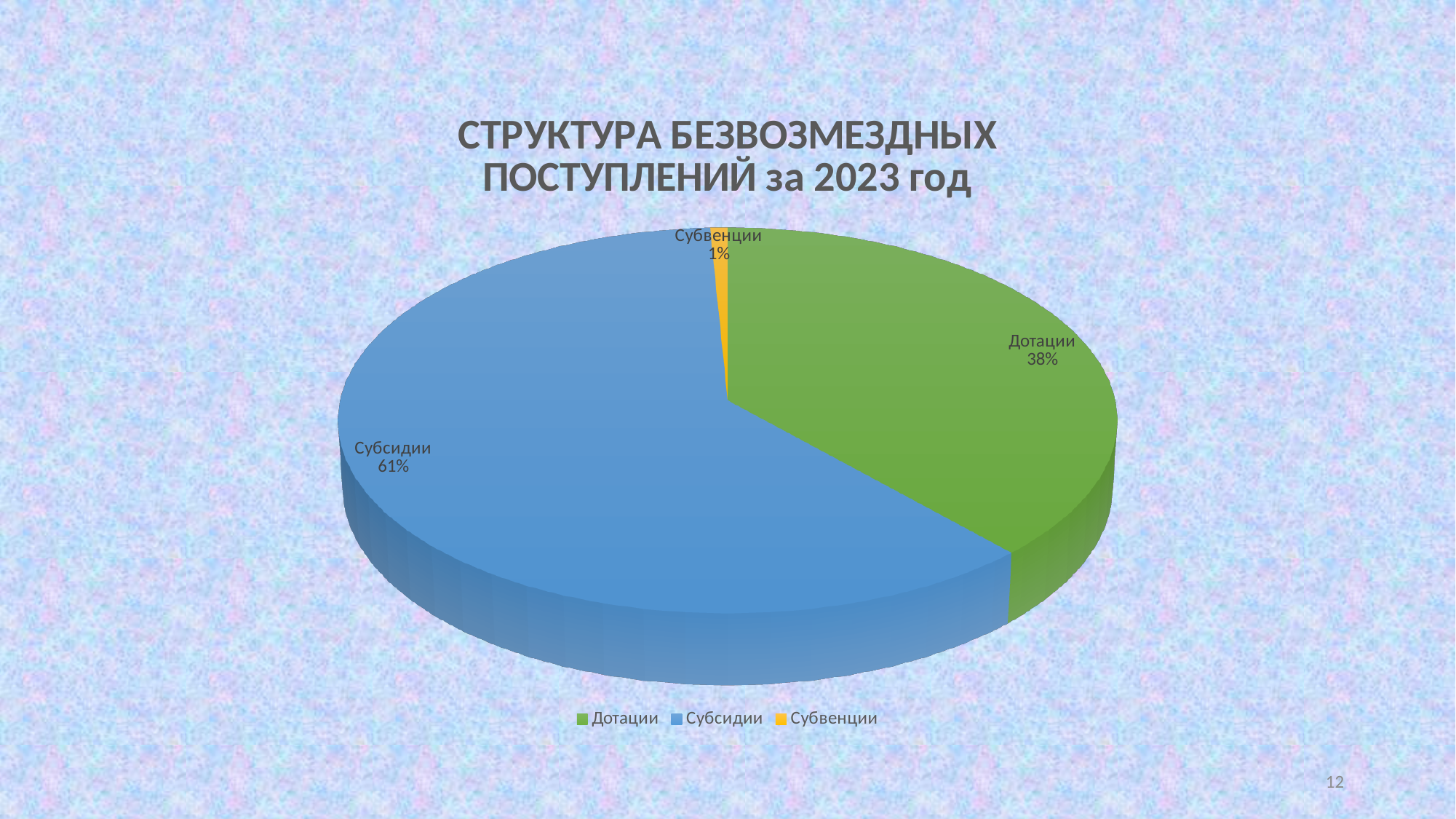
What share of the pie does Субсидии account for? 61% What is the title of the chart? СТРУКТУРА БЕЗВОЗМЕЗДНЫХ ПОСТУПЛЕНИЙ за 2023 год Which category has the smallest share of the pie? Субвенции What share of the pie does Дотации account for? 38% Which is larger, the share of Дотации or the share of Субвенции? Дотации What kind of chart is shown on the slide? Pie chart What share of the pie does Субвенции account for? 1% Which category has the largest share of the pie? Субсидии What is the difference in percentage points between the shares of Субсидии and Дотации? 23 What is the combined share of Дотации and Субвенции? 39% How many categories are shown in the pie chart? 3 Which colour represents Субвенции in the chart? Yellow